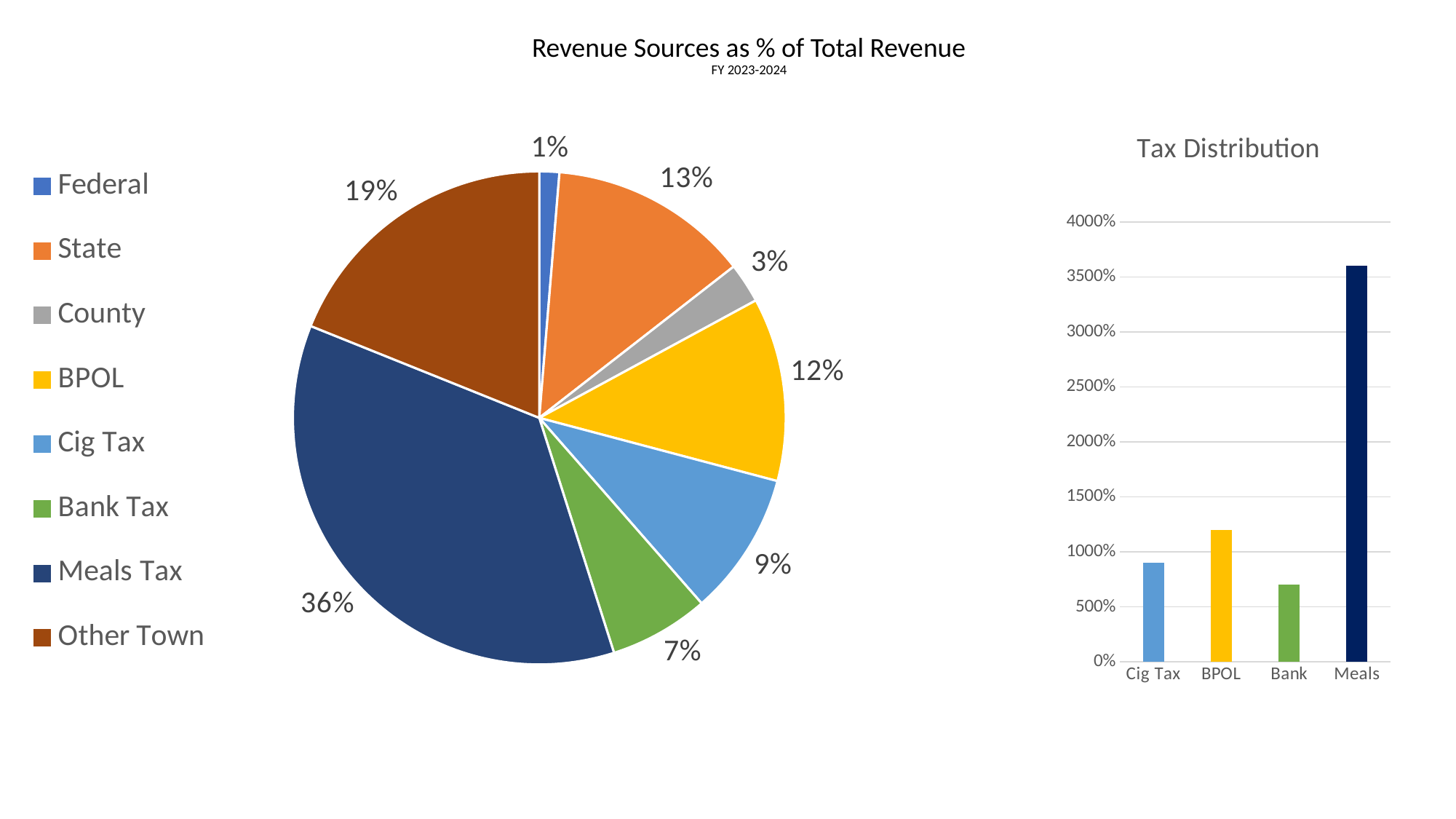
In the Tax Distribution bar chart, is the value for Bank greater or less than 1000%? less In the Revenue Sources as % of Total Revenue pie chart, what share does State have? 13% In the Revenue Sources as % of Total Revenue pie chart, which revenue source has the largest share? Meals Tax In the Revenue Sources as % of Total Revenue pie chart, which is larger, State or BPOL? State In the Revenue Sources as % of Total Revenue pie chart, what share does Other Town have? 19% What type of chart is the Tax Distribution chart on the right? Bar chart How many revenue sources are listed in the legend of the Revenue Sources as % of Total Revenue pie chart? 8 In the Revenue Sources as % of Total Revenue pie chart, what is the difference in percentage points between BPOL and Cig Tax? 3 In the Revenue Sources as % of Total Revenue pie chart, which revenue source has the smallest share? Federal In the Tax Distribution bar chart, is the value for Meals greater or less than 3000%? greater In the Tax Distribution bar chart, which category has the lowest bar? Bank In the Revenue Sources as % of Total Revenue pie chart, what share does Meals Tax have? 36%